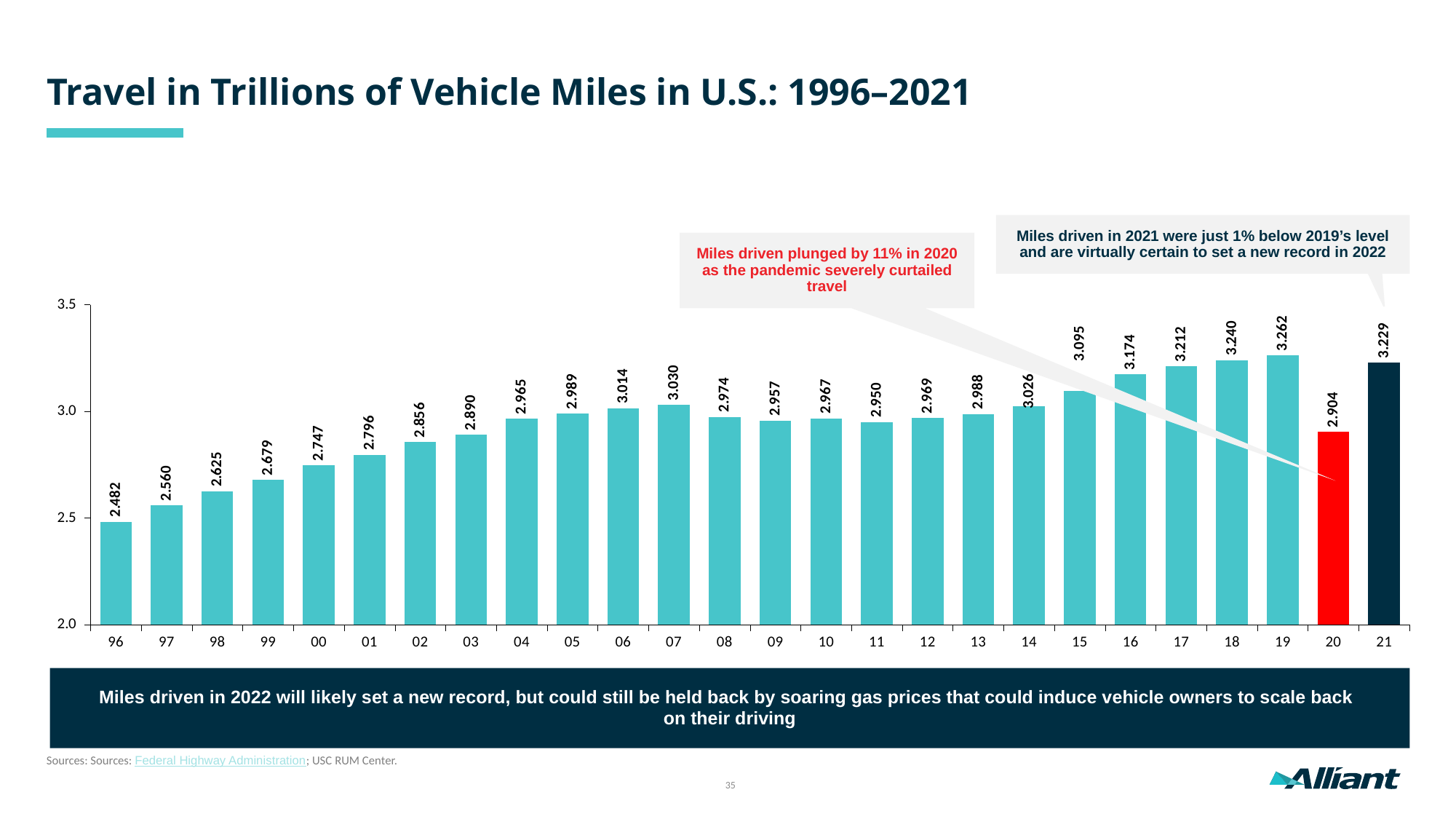
What kind of chart is shown on the slide? Bar chart Which year has the highest value? 19 What is the difference between the values for 19 and 20? 0.358 Do the values rise or fall from 96 to 07? Rise What is the value for 96 (1996)? 2.482 Which is larger, the value for 07 or the value for 08? 07 How many years (bars) are shown in the chart? 26 Is the value for 15 greater or less than 3.0? greater What is the value for 20 (2020)? 2.904 What is the value for 21 (2021)? 3.229 Which year has the lowest value? 96 What is the value for 19 (2019)? 3.262